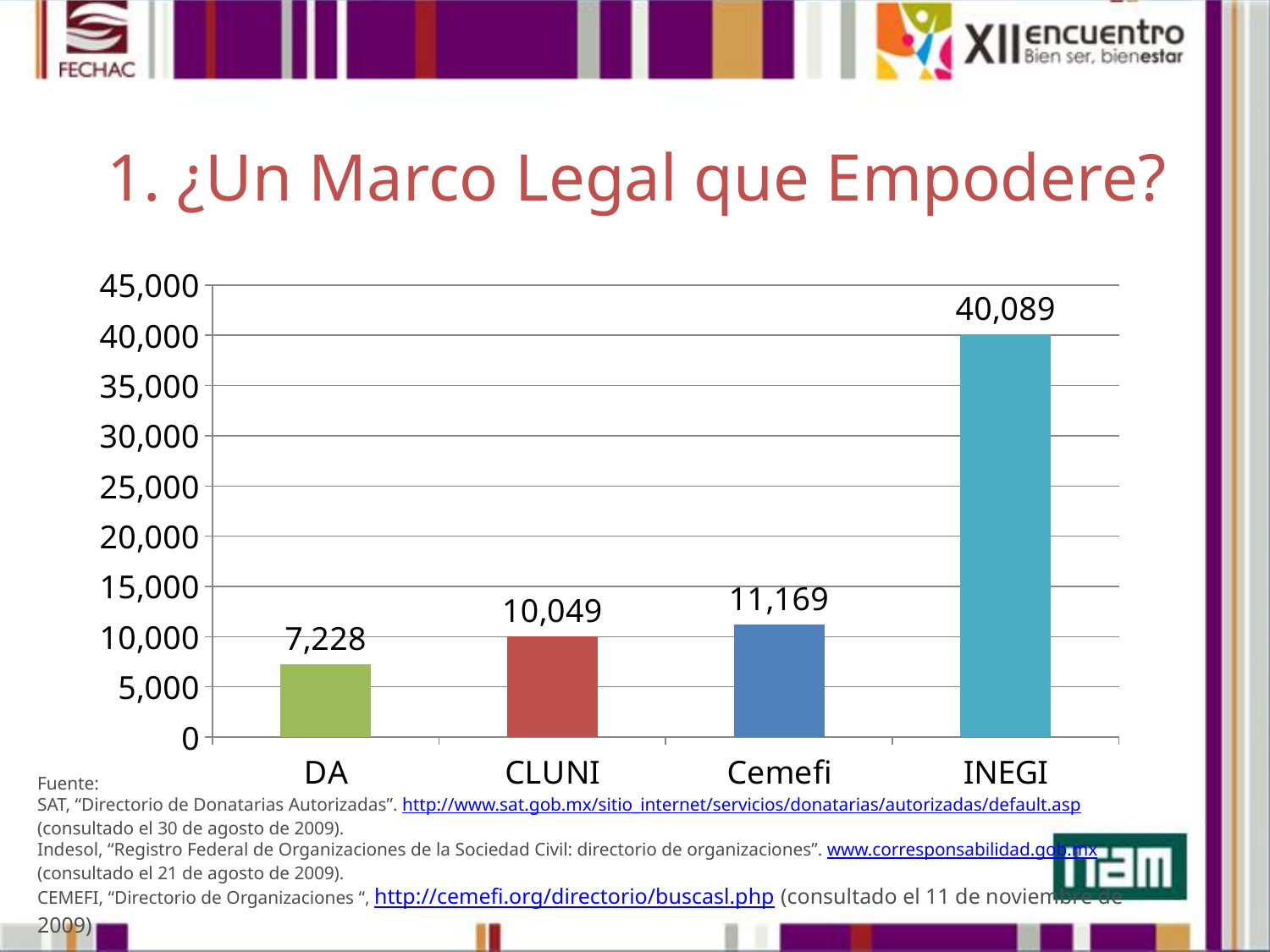
How many categories are shown on the x axis? 4 Which category has the highest value? INEGI Which category has the lowest value? DA What is the value for CLUNI? 10,049 What is the difference between the values for CLUNI and DA? 2,821 Is the value for INEGI greater or less than 35,000? greater What is the value for DA? 7,228 What is the value for Cemefi? 11,169 Which is larger, the value for Cemefi or the value for CLUNI? Cemefi What kind of chart is shown on the slide? bar chart What is the value for INEGI? 40,089 What is the difference between the values for INEGI and Cemefi? 28,920